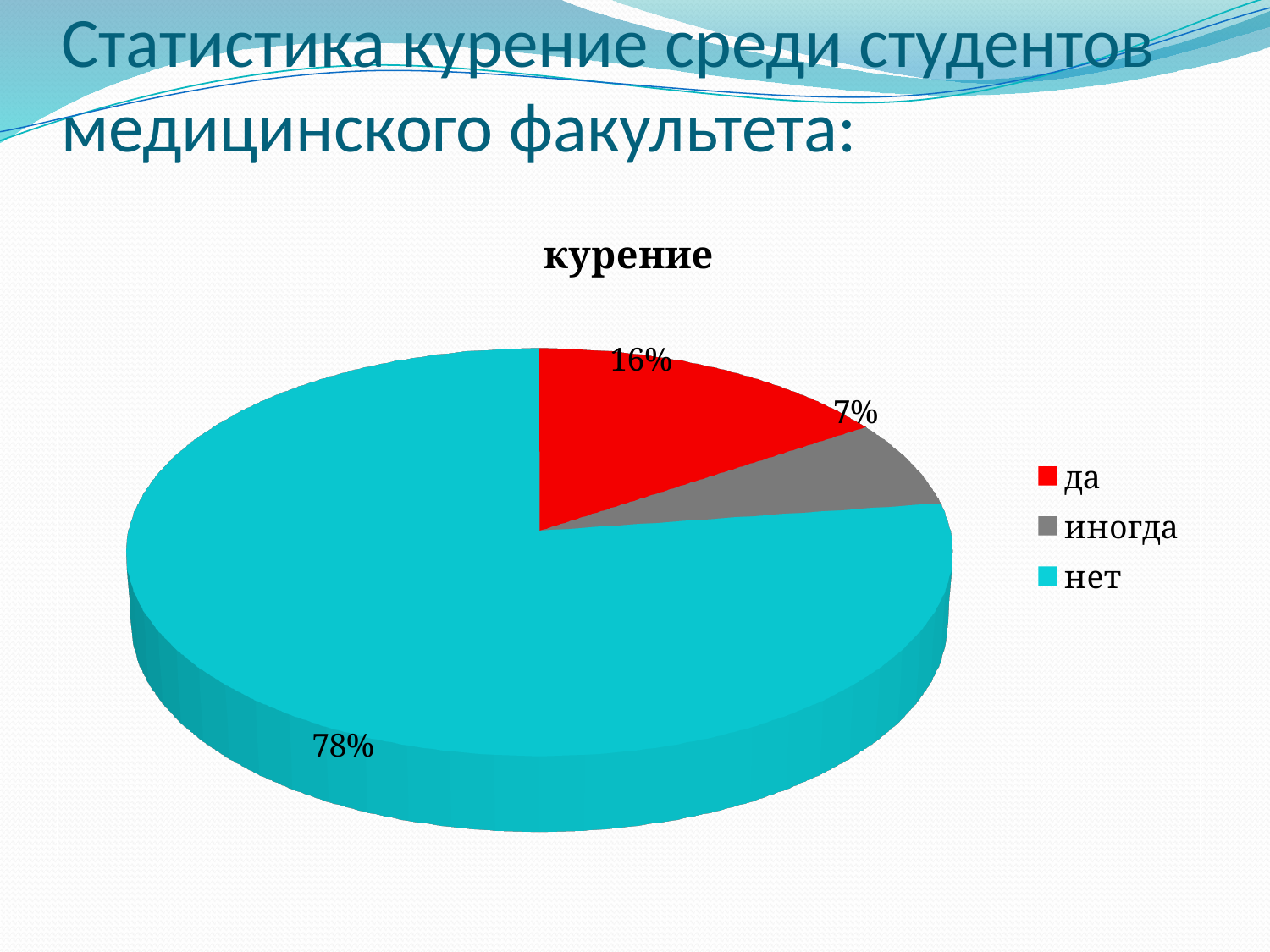
What is the difference in percentage points between "да" and "иногда"? 9 What percentage of the pie is labelled "нет"? 78% What percentage of the pie is labelled "иногда"? 7% What percentage of the pie is labelled "да"? 16% What is the title of the chart? курение What kind of chart is shown on the slide? pie chart How many categories does the legend list? 3 What colour is the slice for "нет"? cyan What is the difference in percentage points between "нет" and "да"? 62 Which category has the largest share of the pie? нет Which category has the smallest share of the pie? иногда Which is larger, the share for "да" or the share for "иногда"? да